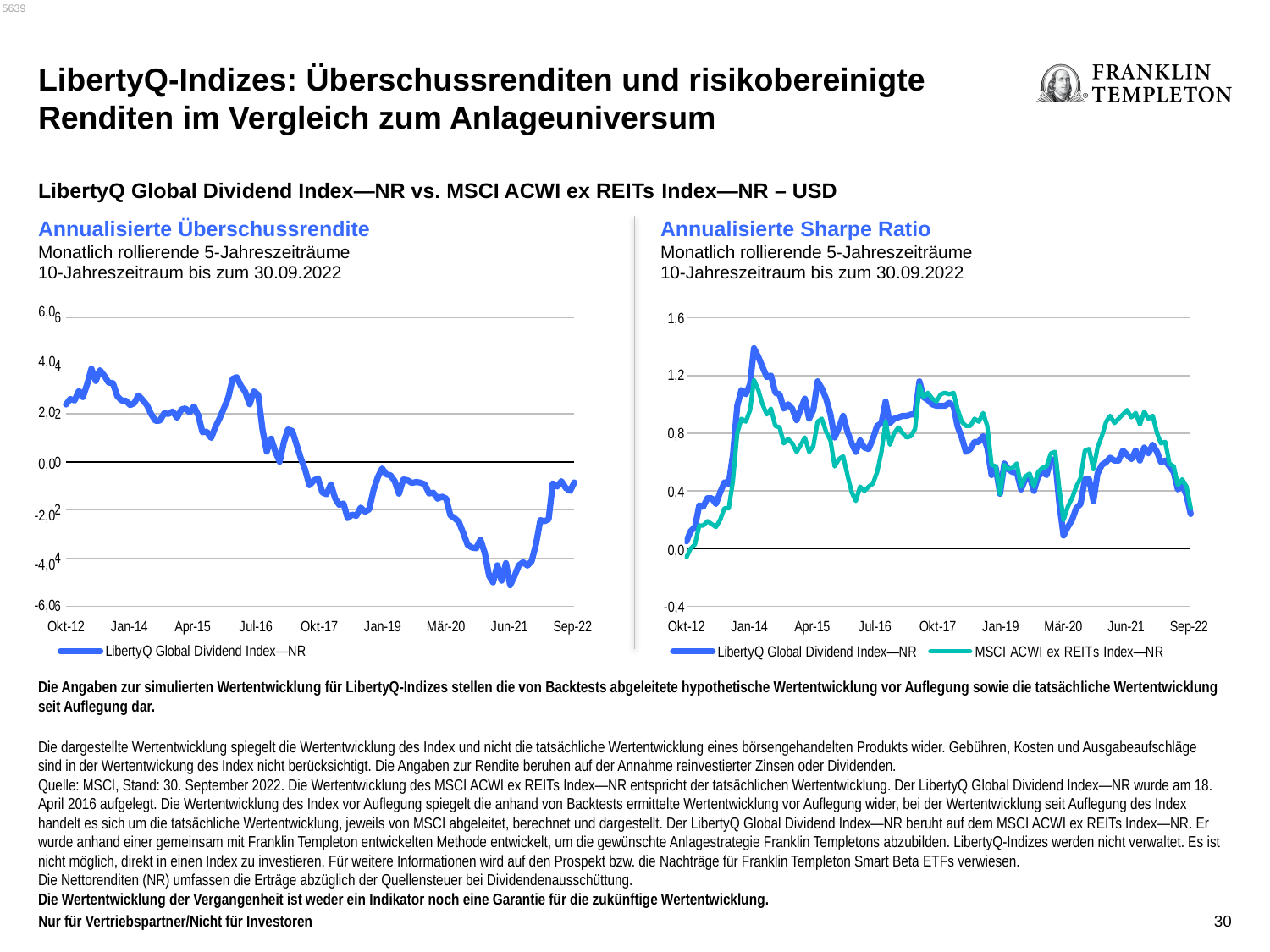
In the 'Annualisierte Sharpe Ratio' chart, does the LibertyQ Global Dividend Index—NR line rise or fall between Okt-12 and Jan-14? rise In the 'Annualisierte Überschussrendite' chart, is the value for LibertyQ Global Dividend Index—NR at Okt-12 greater or less than 2,0? greater In the 'Annualisierte Sharpe Ratio' chart, which two series are listed in the legend? LibertyQ Global Dividend Index—NR and MSCI ACWI ex REITs Index—NR How many date labels are shown on the x axis of the 'Annualisierte Überschussrendite' chart? 9 In the 'Annualisierte Überschussrendite' chart, how many series does the legend list? 1 In the 'Annualisierte Überschussrendite' chart, does the LibertyQ Global Dividend Index—NR line end at Sep-22 higher or lower than it starts at Okt-12? lower In the 'Annualisierte Sharpe Ratio' chart, is the value for LibertyQ Global Dividend Index—NR at its dip around Mär-20 greater or less than 0,4? less What kind of chart is the right chart titled 'Annualisierte Sharpe Ratio'? line chart In the 'Annualisierte Sharpe Ratio' chart, how many series does the legend list? 2 What kind of chart is the left chart titled 'Annualisierte Überschussrendite'? line chart In the 'Annualisierte Sharpe Ratio' chart, is the peak value of LibertyQ Global Dividend Index—NR near Jan-14 greater or less than 1,2? greater